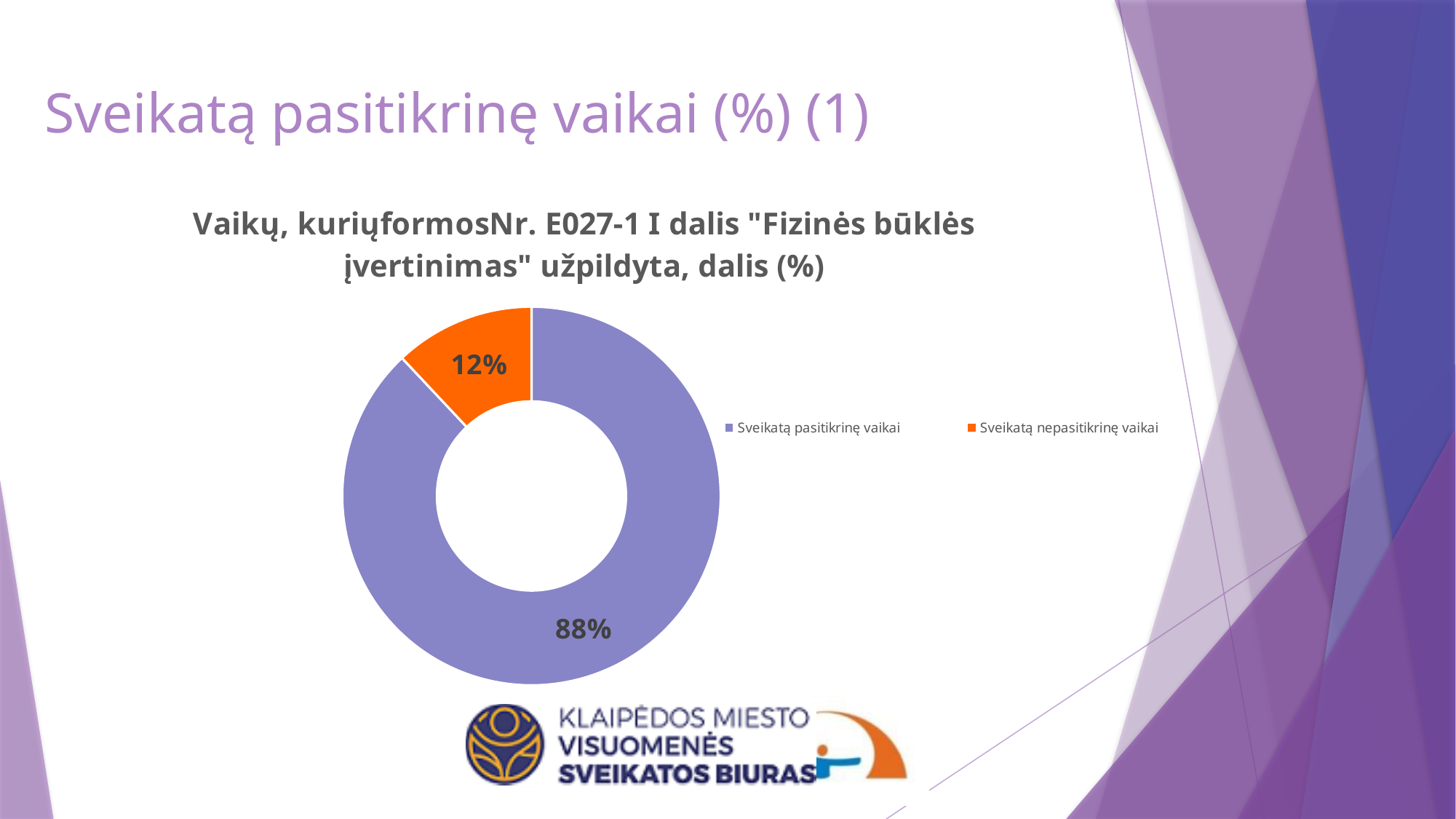
What kind of chart is shown on the slide? Doughnut (pie) chart How many categories does the chart show? 2 Which category has the smallest share of the chart? Sveikatą nepasitikrinę vaikai What share of the chart is labelled "Sveikatą nepasitikrinę vaikai"? 12% What colour is the "Sveikatą nepasitikrinę vaikai" slice? Orange What share of the chart is labelled "Sveikatą pasitikrinę vaikai"? 88% What is the difference in percentage points between the "Sveikatą pasitikrinę vaikai" and "Sveikatą nepasitikrinę vaikai" shares? 76 percentage points How many entries does the legend list? 2 What is the total of the two shares shown in the chart? 100% Which is larger: the share for "Sveikatą pasitikrinę vaikai" or for "Sveikatą nepasitikrinę vaikai"? Sveikatą pasitikrinę vaikai Which category has the largest share of the chart? Sveikatą pasitikrinę vaikai What colour is the "Sveikatą pasitikrinę vaikai" slice? Purple